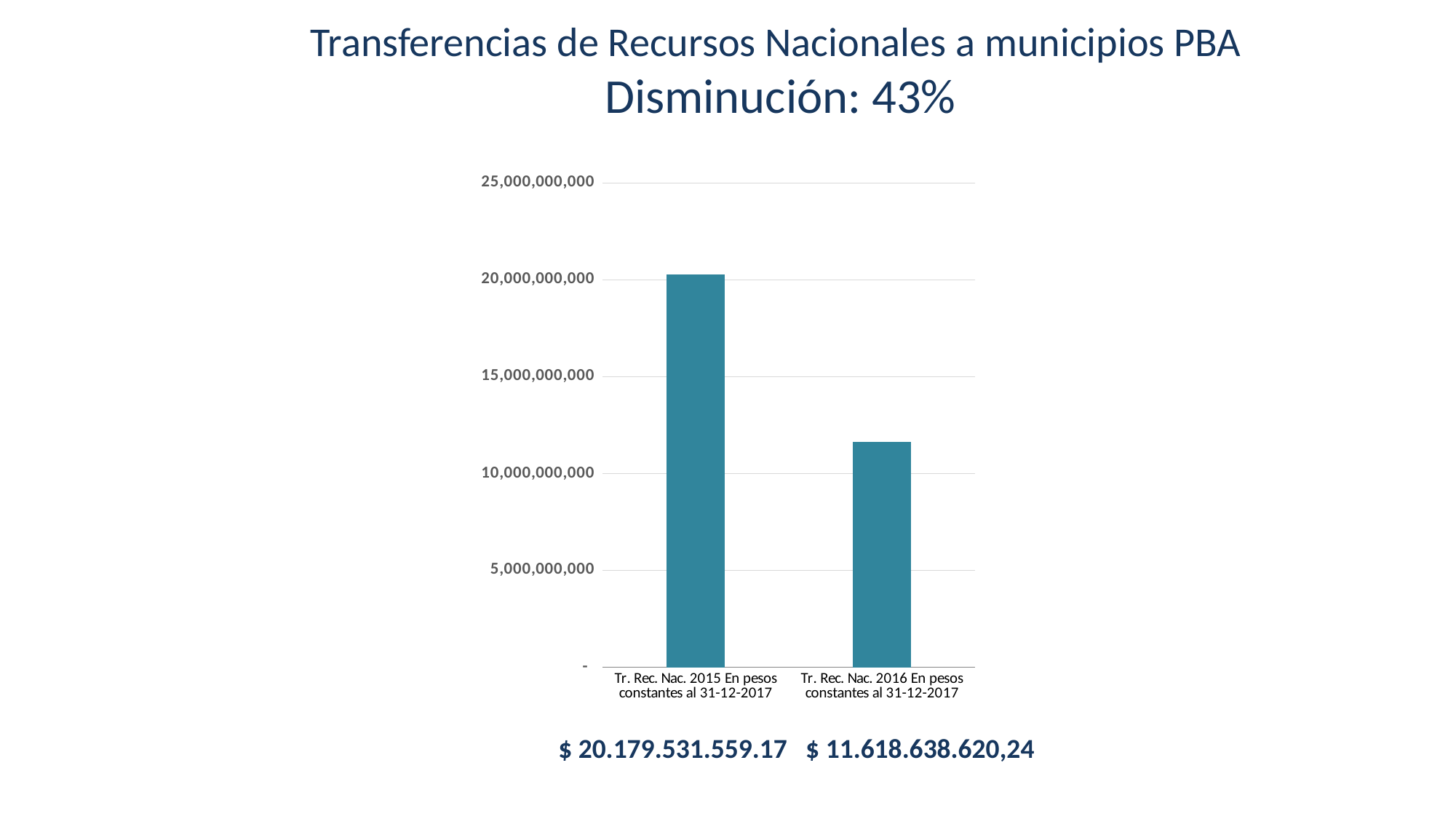
What is the value shown for Tr. Rec. Nac. 2015 En pesos constantes al 31-12-2017? $ 20.179.531.559.17 What percentage decrease (Disminución) does the slide title state? 43% How many bars are plotted in the chart? 2 Which category has the highest bar? Tr. Rec. Nac. 2015 En pesos constantes al 31-12-2017 Is the value for Tr. Rec. Nac. 2015 greater or less than 15,000,000,000? greater Do the values rise or fall from 2015 to 2016? fall Is the value for Tr. Rec. Nac. 2016 greater or less than 10,000,000,000? greater Is the value for Tr. Rec. Nac. 2016 greater or less than 15,000,000,000? less Which category has the lowest bar? Tr. Rec. Nac. 2016 En pesos constantes al 31-12-2017 What kind of chart is shown on the slide? bar chart What is the value shown for Tr. Rec. Nac. 2016 En pesos constantes al 31-12-2017? $ 11.618.638.620,24 Which is larger, the value for 2015 or the value for 2016? 2015